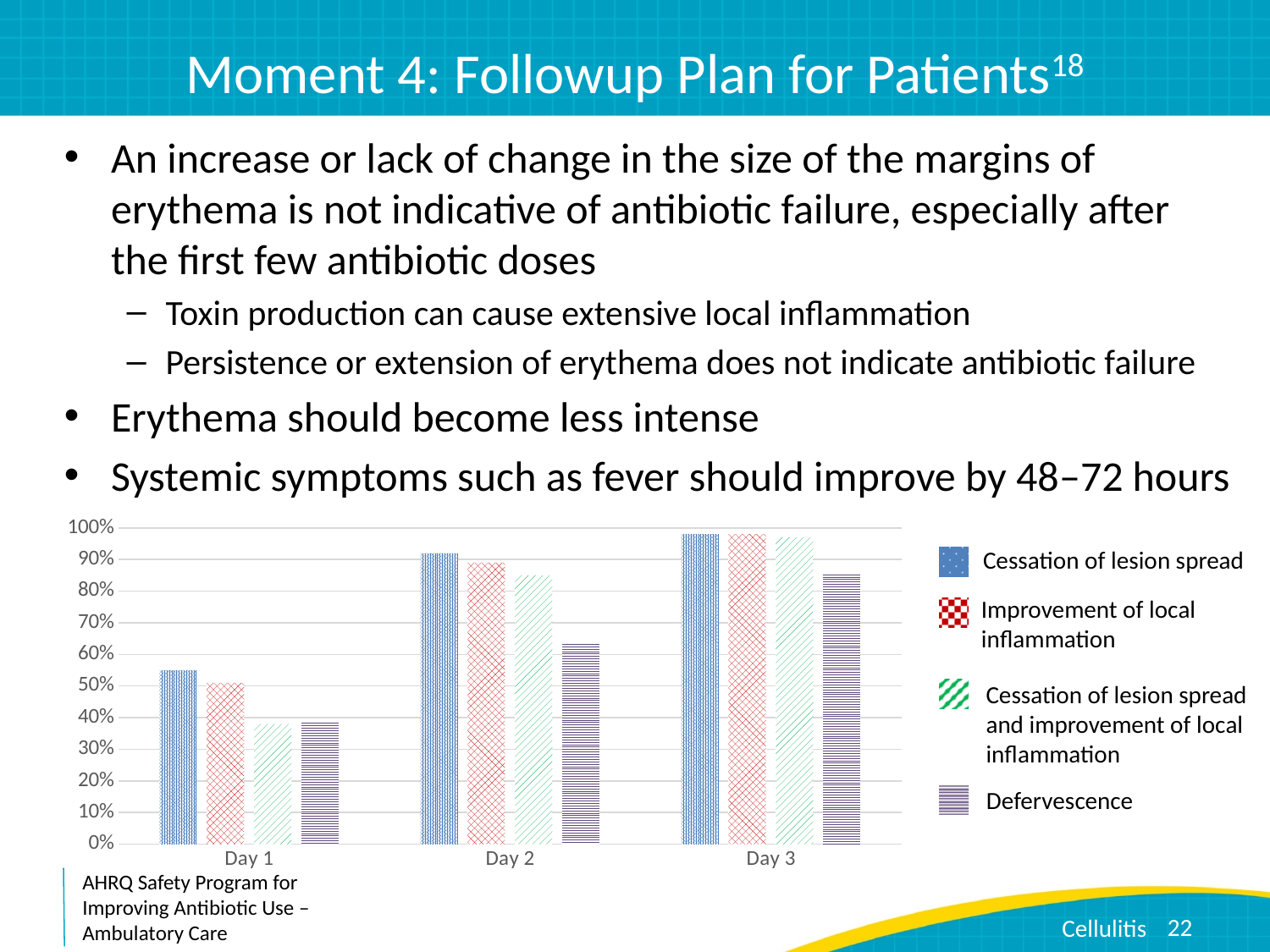
Does the value for Cessation of lesion spread rise or fall from Day 1 to Day 3? rise Which day has the lowest value for Defervescence? Day 1 Which legend entry is shown with a blue pattern? Cessation of lesion spread On Day 2, which series has the lowest value? Defervescence Is the value for Defervescence on Day 1 greater or less than 50%? less How many series does the chart's legend list? 4 What kind of chart is shown on the slide? bar chart On Day 1, which is larger: Cessation of lesion spread or Defervescence? Cessation of lesion spread Is the value for Defervescence on Day 2 greater or less than 50%? greater Is the value for Cessation of lesion spread on Day 2 greater or less than 80%? greater How many day categories are shown on the x axis of the chart? 3